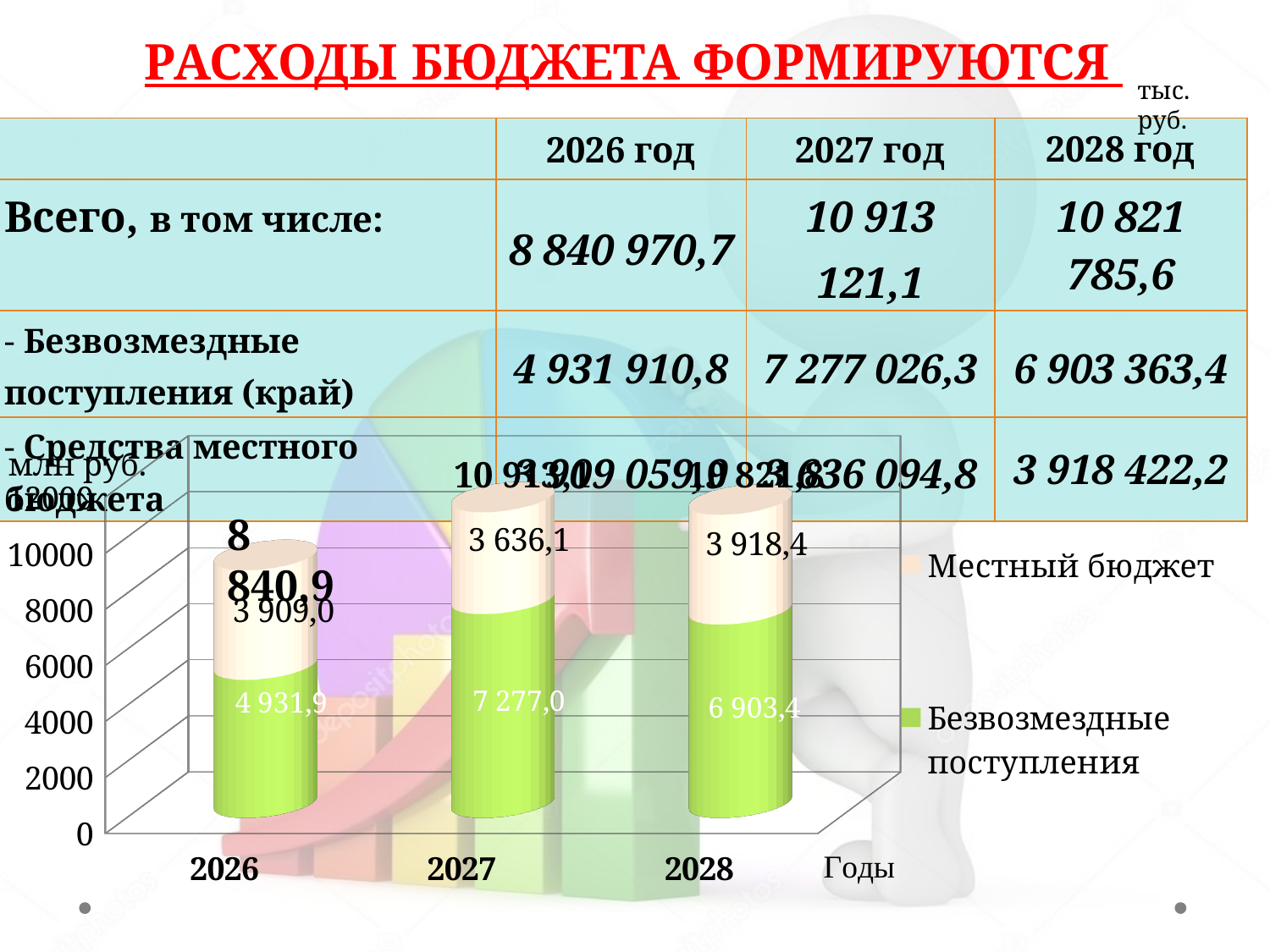
How many series does the chart legend list? 2 What is the value of Безвозмездные поступления for 2027? 7 277,0 Which is larger: Местный бюджет in 2028 or in 2026? 2028 How many years are shown on the x axis of the chart? 3 In which year is Местный бюджет the lowest? 2027 What is the value of Безвозмездные поступления for 2026? 4 931,9 By how much does Безвозмездные поступления in 2027 exceed that in 2026? 2 345,1 What kind of chart is shown on the slide? Stacked bar chart What is the total of the stacked bar for 2027? 10 913,1 What is the value of Местный бюджет for 2026? 3 909,0 What is the value of Местный бюджет for 2028? 3 918,4 In which year is Безвозмездные поступления the highest? 2027